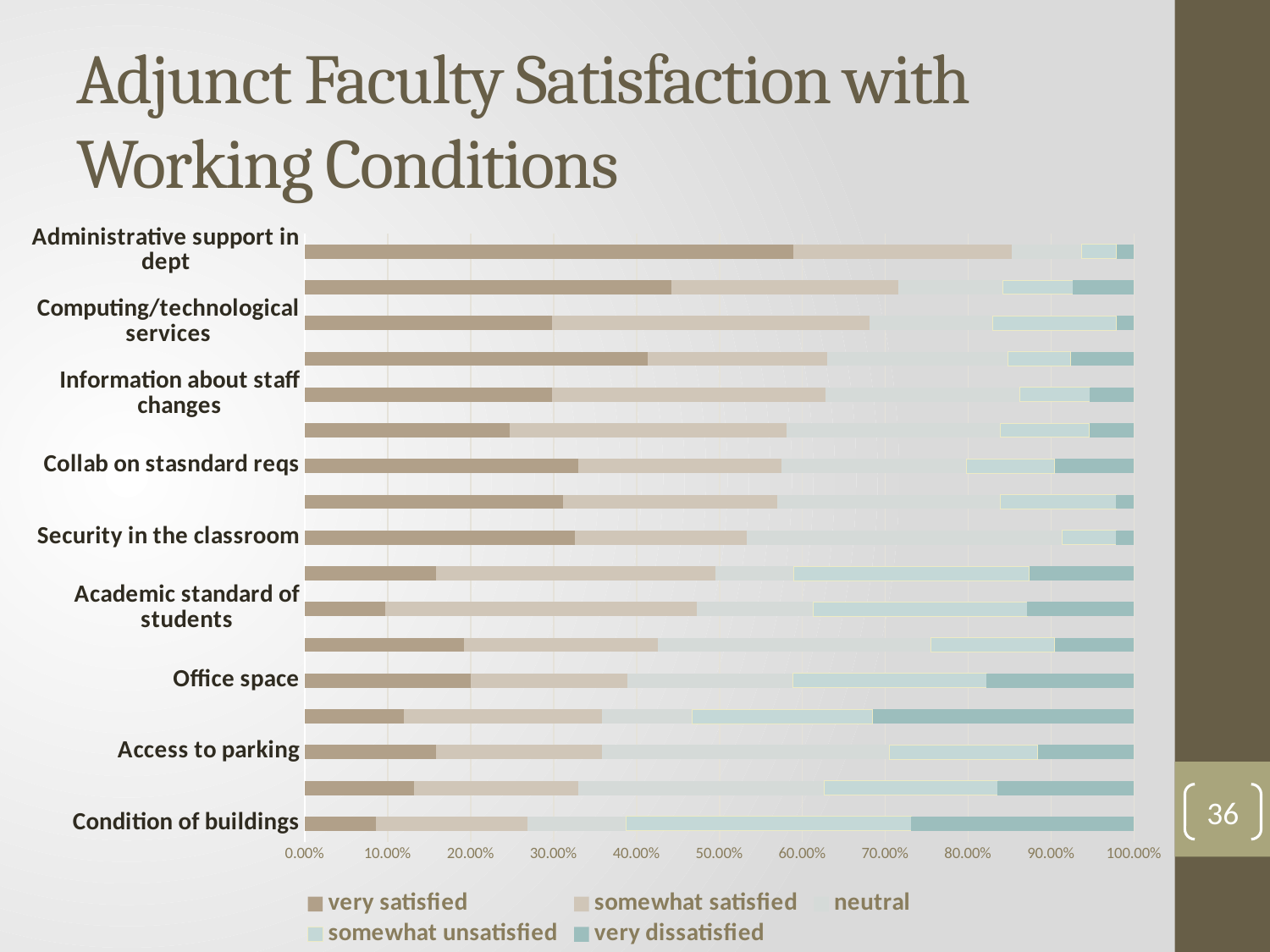
How many bars are plotted in the chart? 17 What kind of chart is shown on the slide? bar chart Which has the larger 'very satisfied' segment: Administrative support in dept or Condition of buildings? Administrative support in dept Is the 'very satisfied' value for Condition of buildings greater or less than 20.00%? less What is the title of the slide containing the chart? Adjunct Faculty Satisfaction with Working Conditions Among the labeled categories, which has the largest 'very satisfied' segment? Administrative support in dept Is the 'very satisfied' value for Administrative support in dept greater or less than 50.00%? greater Among the labeled categories, which has the largest 'very dissatisfied' segment? Condition of buildings What are the legend entries of the chart? very satisfied, somewhat satisfied, neutral, somewhat unsatisfied, very dissatisfied Is the 'very dissatisfied' value for Condition of buildings greater or less than 20.00%? greater How many series does the legend list? 5 How many category labels are printed on the vertical axis of the chart? 9